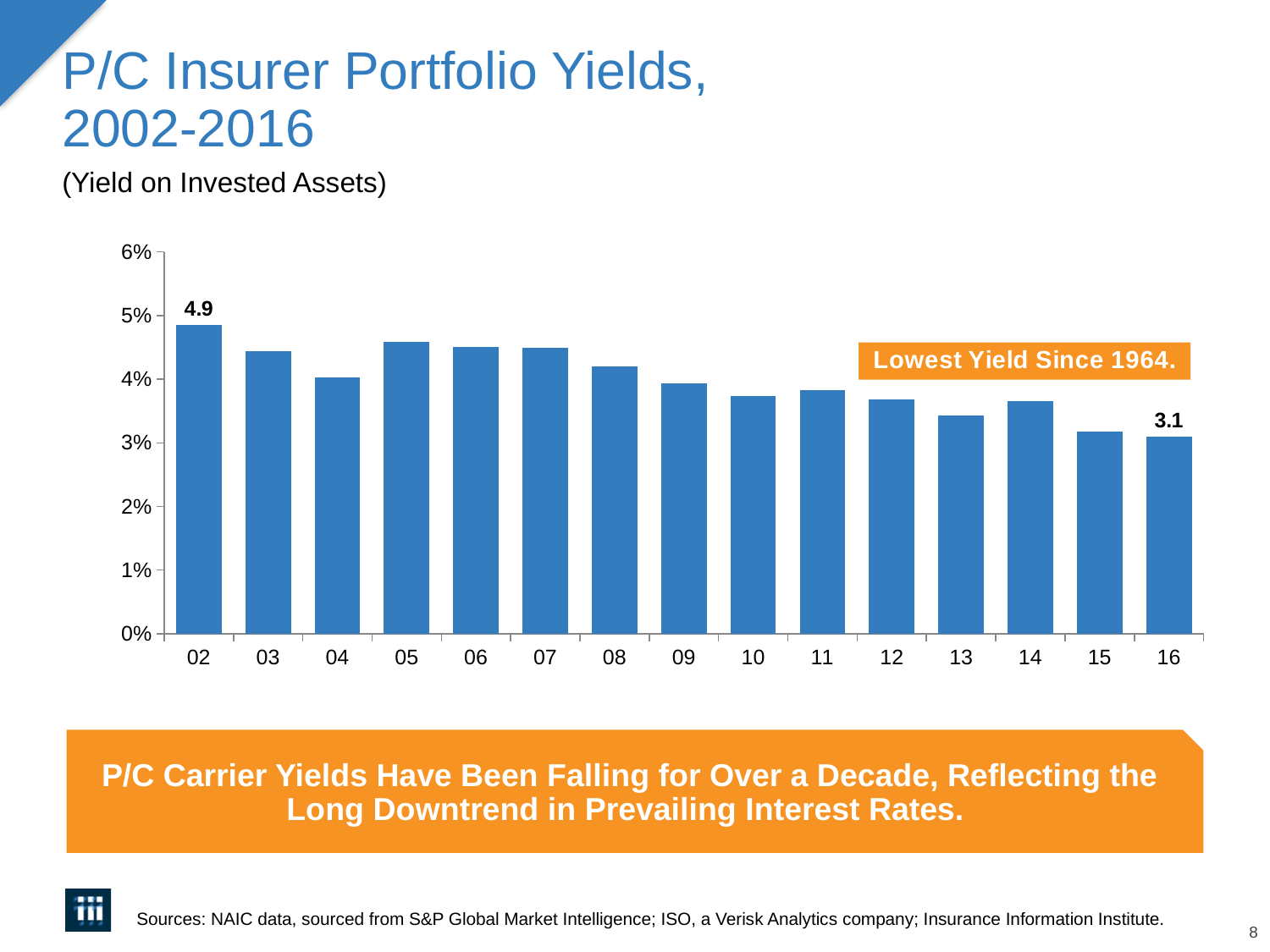
Is the value for 05 greater or less than 4%? greater What is the portfolio yield shown for 02? 4.9 Which year has the larger yield, 04 or 05? 05 Which year has the lowest portfolio yield? 16 Which year has the highest portfolio yield? 02 Do the portfolio yields generally rise or fall from 02 to 16? Fall How many years are plotted in the chart? 15 What kind of chart is shown on the slide? Bar chart What is the difference between the yield in 02 and the yield in 16? 1.8 Is the value for 13 greater or less than 4%? less What is the portfolio yield shown for 16? 3.1 What does the orange callout box on the chart say? Lowest Yield Since 1964.